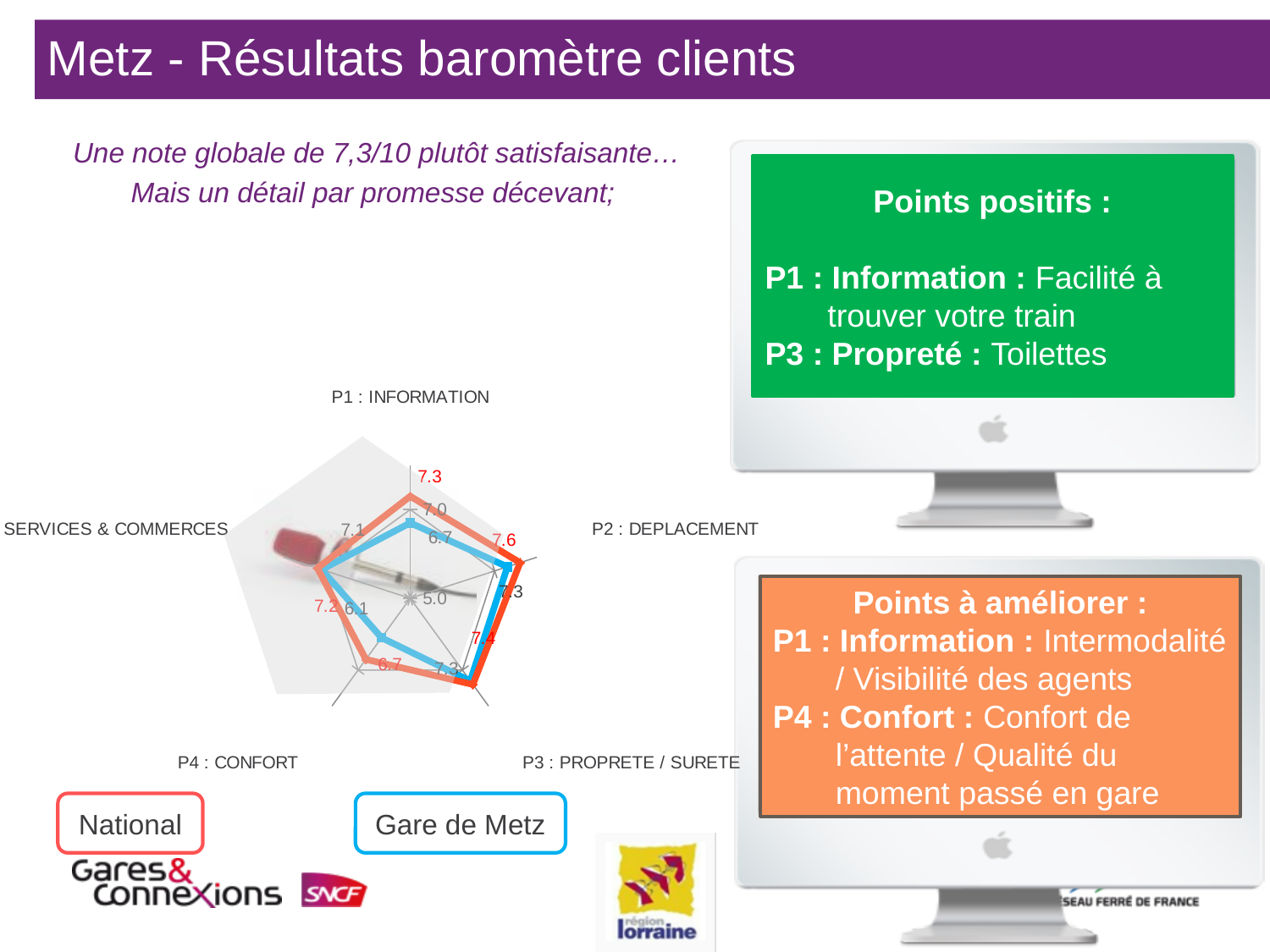
Which series has the higher value for P1 : INFORMATION, National or Gare de Metz? National What is the Gare de Metz value for P2 : DEPLACEMENT? 7.3 What is the National value for P2 : DEPLACEMENT? 7.6 How many series does the legend list? 2 What is the Gare de Metz value for P1 : INFORMATION? 6.7 Which series is drawn in red? National What kind of chart is shown on the slide? Radar chart What is the difference between the National and Gare de Metz values for P2 : DEPLACEMENT? 0.3 What is the National value for P1 : INFORMATION? 7.3 On which axis does the National series reach its highest value? P2 : DEPLACEMENT Which series is drawn in blue? Gare de Metz What is the difference between the National and Gare de Metz values for P1 : INFORMATION? 0.6